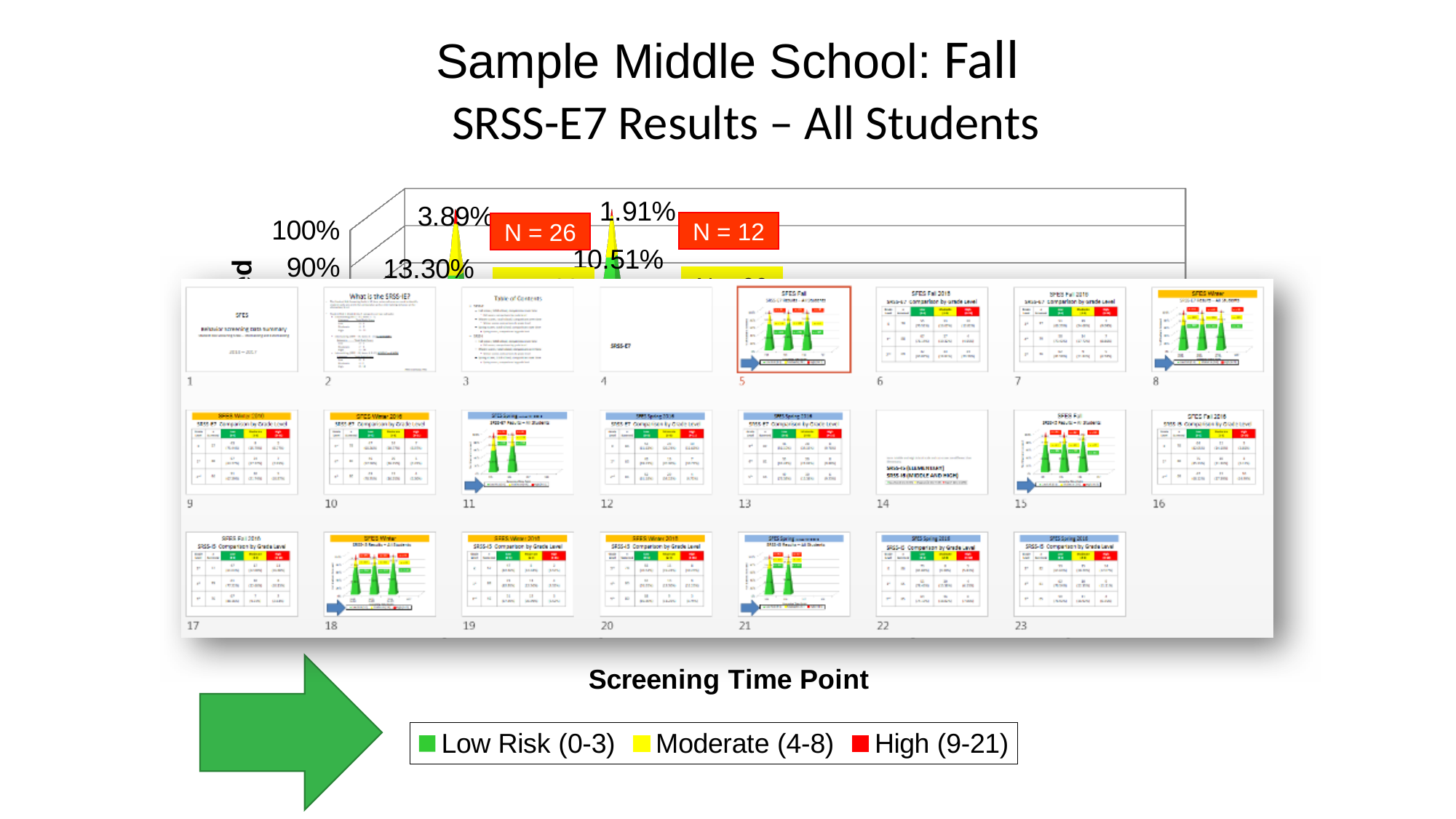
What N value is shown in the red box above the second cone? N = 12 What is the difference between the two N values shown in the red boxes, N = 26 and N = 12? 14 What colour represents the High (9-21) series in the legend? Red What are the three legend entries on the chart? Low Risk (0-3), Moderate (4-8), High (9-21) What percentage is printed at the top of the second cone from the left in the chart? 1.91% What N value is shown in the red box above the leftmost cone? N = 26 How many series does the chart legend list? 3 What is the difference between the top labels of the first two cones, 3.89% and 1.91%? 1.98% What is the highest tick value shown on the chart's y axis? 100% What percentage is printed at the top of the leftmost cone in the chart? 3.89% What is the title of the chart's x axis? Screening Time Point Which is larger, the top label on the leftmost cone (3.89%) or the top label on the second cone (1.91%)? 3.89%